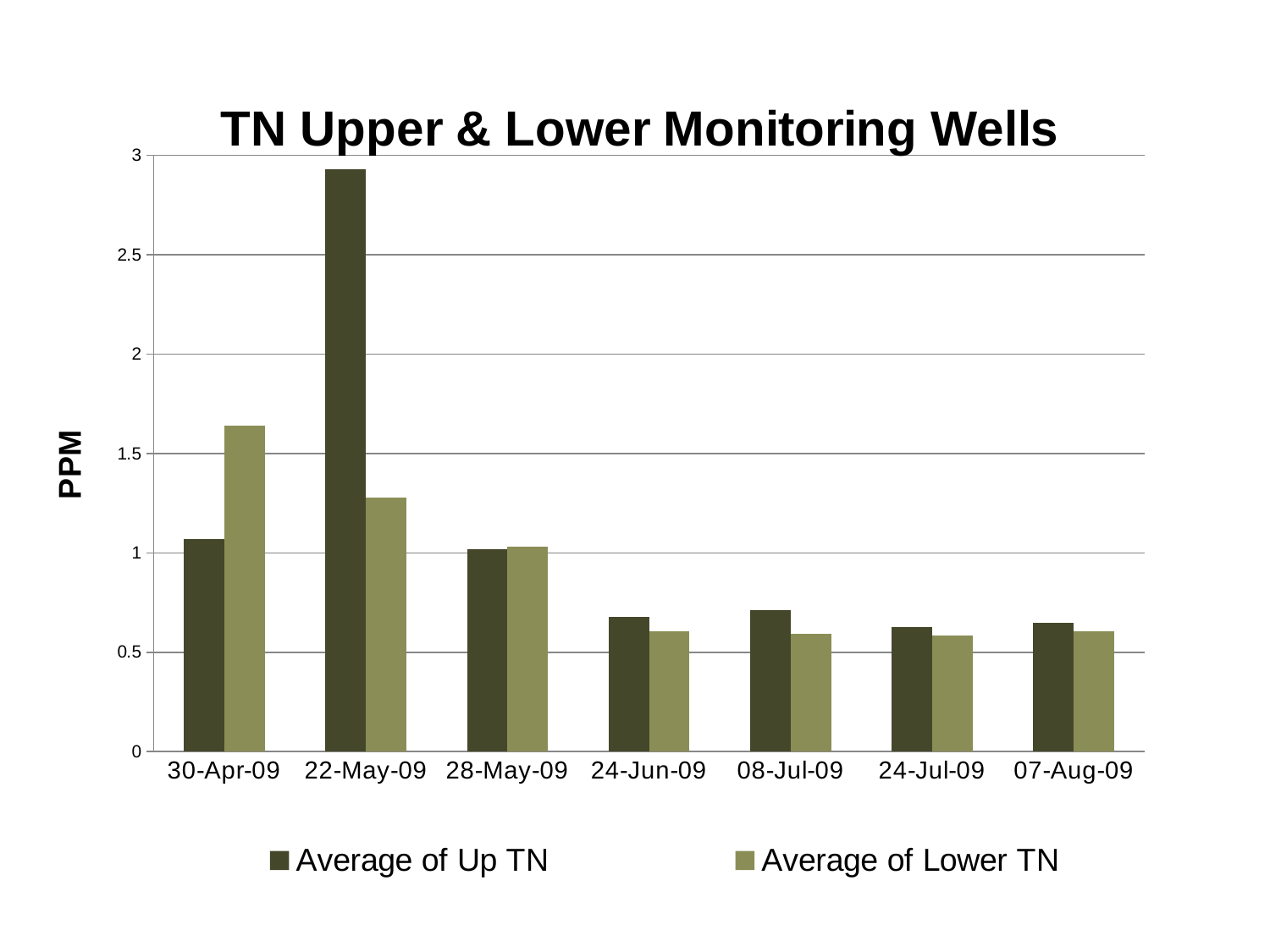
On 30-Apr-09, which is larger: Average of Up TN or Average of Lower TN? Average of Lower TN What is the label on the vertical axis? PPM Is the Average of Up TN for 22-May-09 greater or less than 2.5? greater Does the Average of Lower TN rise or fall from 30-Apr-09 to 24-Jun-09? fall What is the title of the chart? TN Upper & Lower Monitoring Wells How many series does the legend list? 2 On which date is the Average of Lower TN highest? 30-Apr-09 On which date is the Average of Up TN highest? 22-May-09 Is the Average of Lower TN for 30-Apr-09 greater or less than 1.5? greater Is the Average of Up TN for 24-Jun-09 greater or less than 1? less How many dates are shown along the x axis? 7 What type of chart is shown on the slide? bar chart